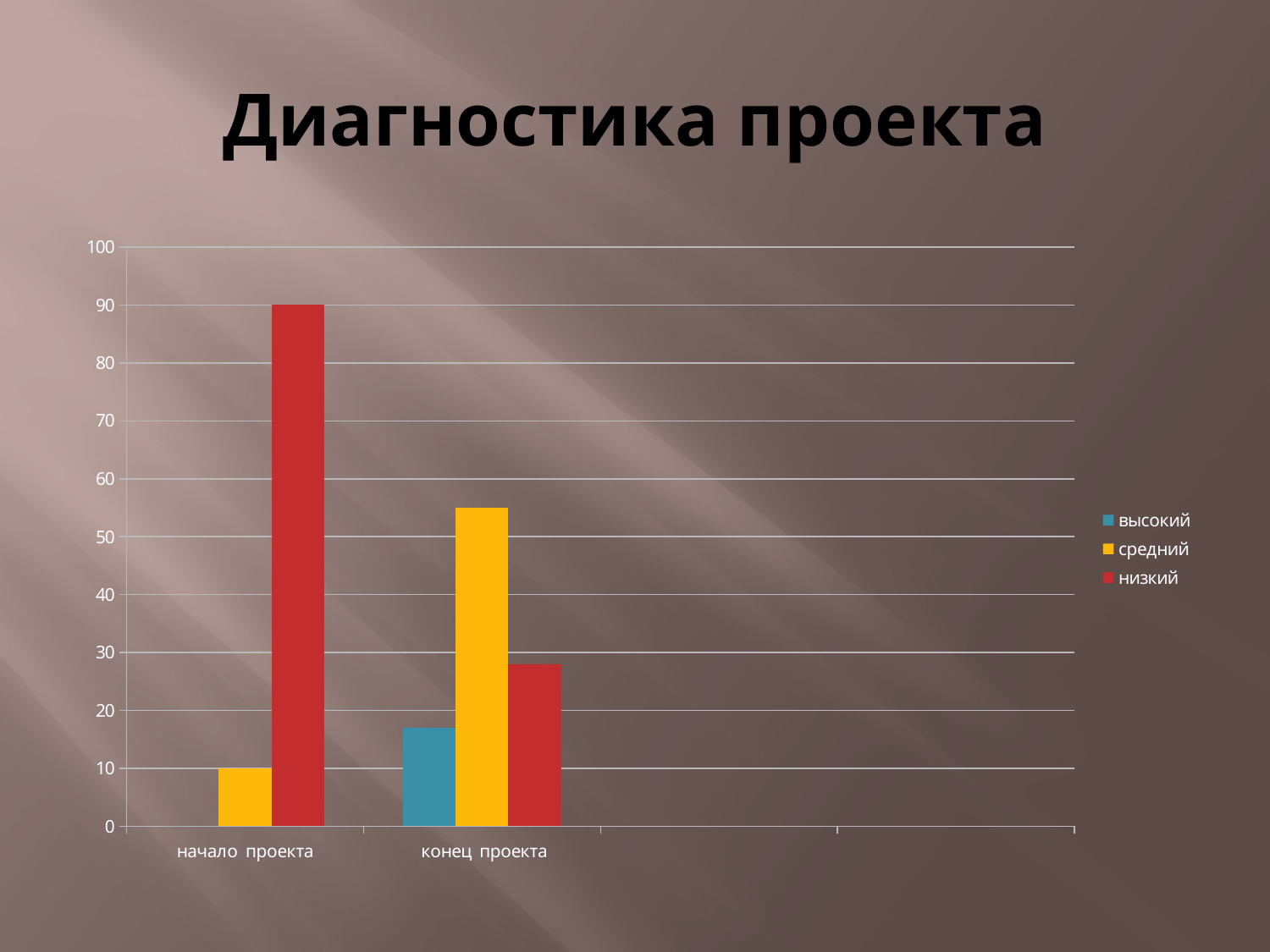
Is the value for высокий at конец проекта greater or less than 20? less How many series does the legend list? 3 What is the difference between низкий and средний at начало проекта? 80 Which series has the highest value at начало проекта? низкий Which is larger: низкий at начало проекта or низкий at конец проекта? низкий at начало проекта What is the slide title? Диагностика проекта How many categories are shown on the x axis? 2 What is the value for низкий at начало проекта? 90 Is the value for средний at конец проекта greater or less than 50? greater Which series has the highest value at конец проекта? средний What is the value for средний at начало проекта? 10 What kind of chart is shown on the slide? bar chart